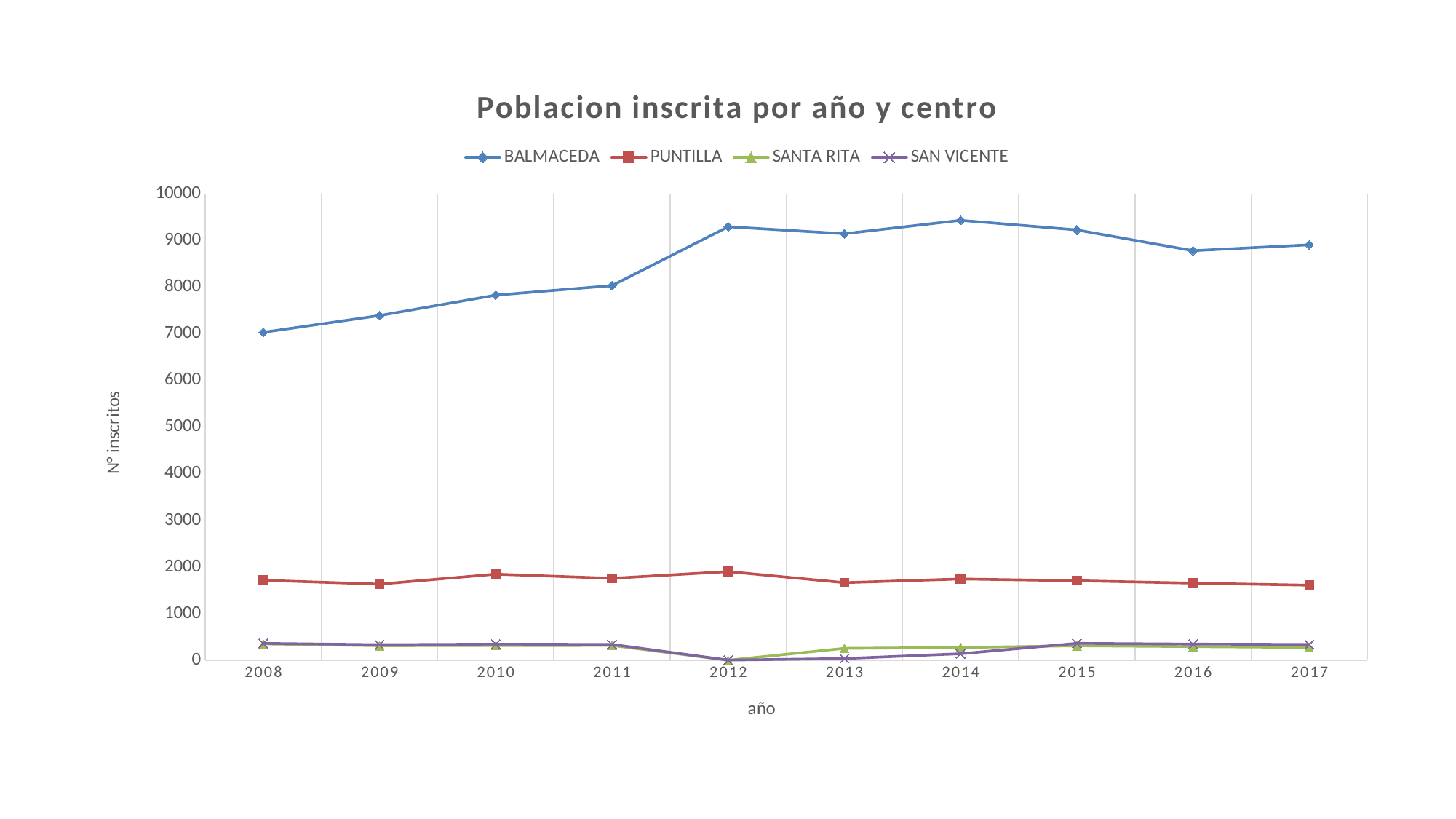
What is the title of the chart? Poblacion inscrita por año y centro Is the value for BALMACEDA in 2012 greater or less than 9000? greater What kind of chart is shown on the slide? line chart How many years are plotted along the x axis? 10 In which year does the BALMACEDA series reach its highest value? 2014 How many series does the legend list? 4 Is the value for BALMACEDA in 2008 greater or less than 8000? less Does the BALMACEDA series rise or fall from 2008 to 2011? rise Is the value for BALMACEDA in 2016 greater or less than 9000? less Which series has the higher value in 2015, BALMACEDA or PUNTILLA? BALMACEDA In which year does the BALMACEDA series have its lowest value? 2008